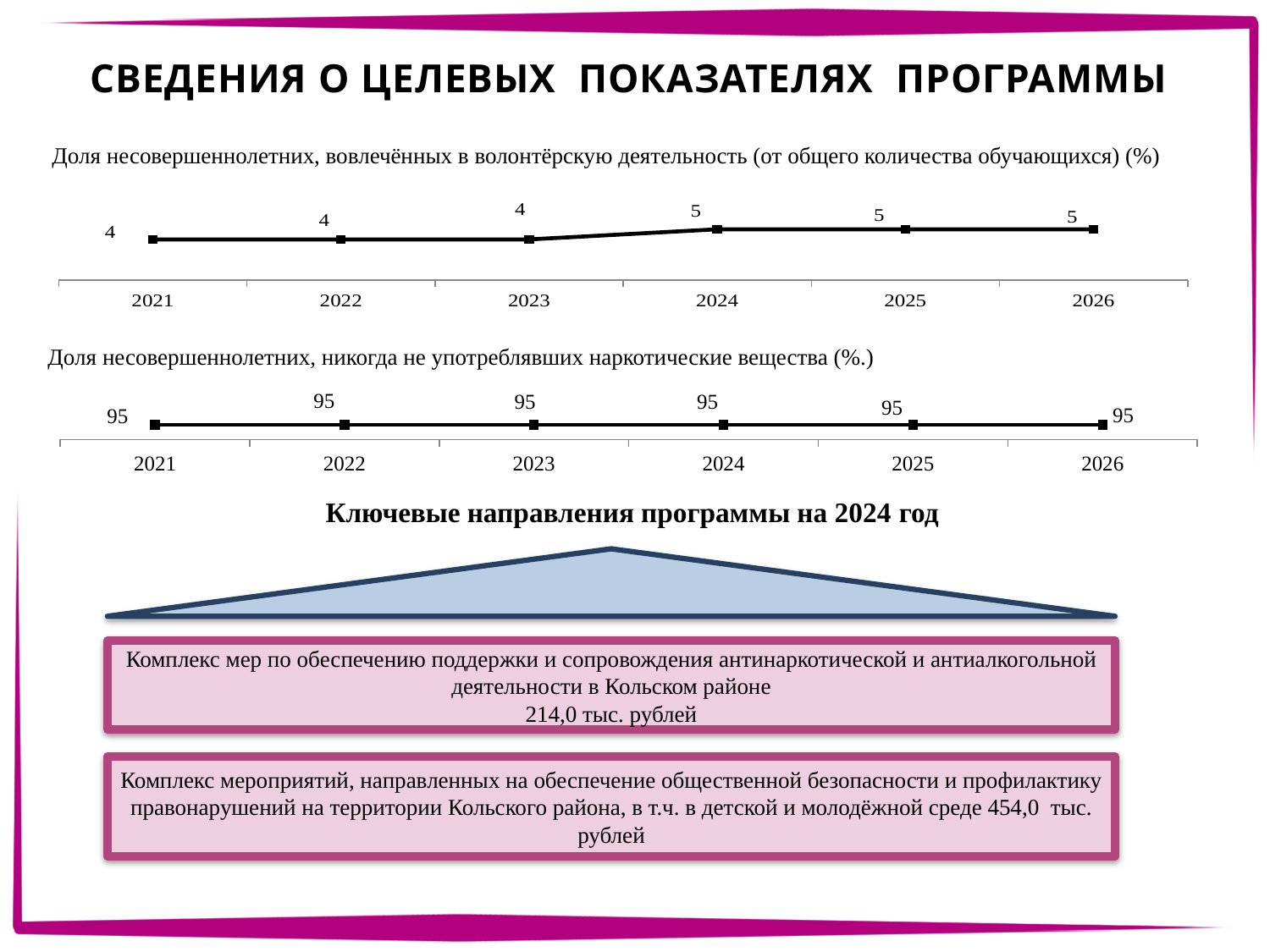
In the top chart (share of minors involved in volunteer activity), what is the value for 2024? 5 In the top chart (share of minors involved in volunteer activity), do the values rise or fall from 2021 to 2026? rise In the top chart (share of minors involved in volunteer activity), what is the difference between the values for 2025 and 2022? 1 What kind of chart is the top chart (share of minors involved in volunteer activity)? line chart In the top chart (share of minors involved in volunteer activity), what is the value for 2021? 4 In the bottom chart (share of minors who never used narcotic substances), what is the value for 2023? 95 In the bottom chart (share of minors who never used narcotic substances), what is the value for 2026? 95 In the top chart (share of minors involved in volunteer activity), what is the value for 2026? 5 In the top chart (share of minors involved in volunteer activity), which is larger, the value for 2023 or the value for 2024? 2024 How many years are plotted in the top chart (share of minors involved in volunteer activity)? 6 How many years are plotted in the bottom chart (share of minors who never used narcotic substances)? 6 In the bottom chart (share of minors who never used narcotic substances), what is the difference between the values for 2021 and 2026? 0